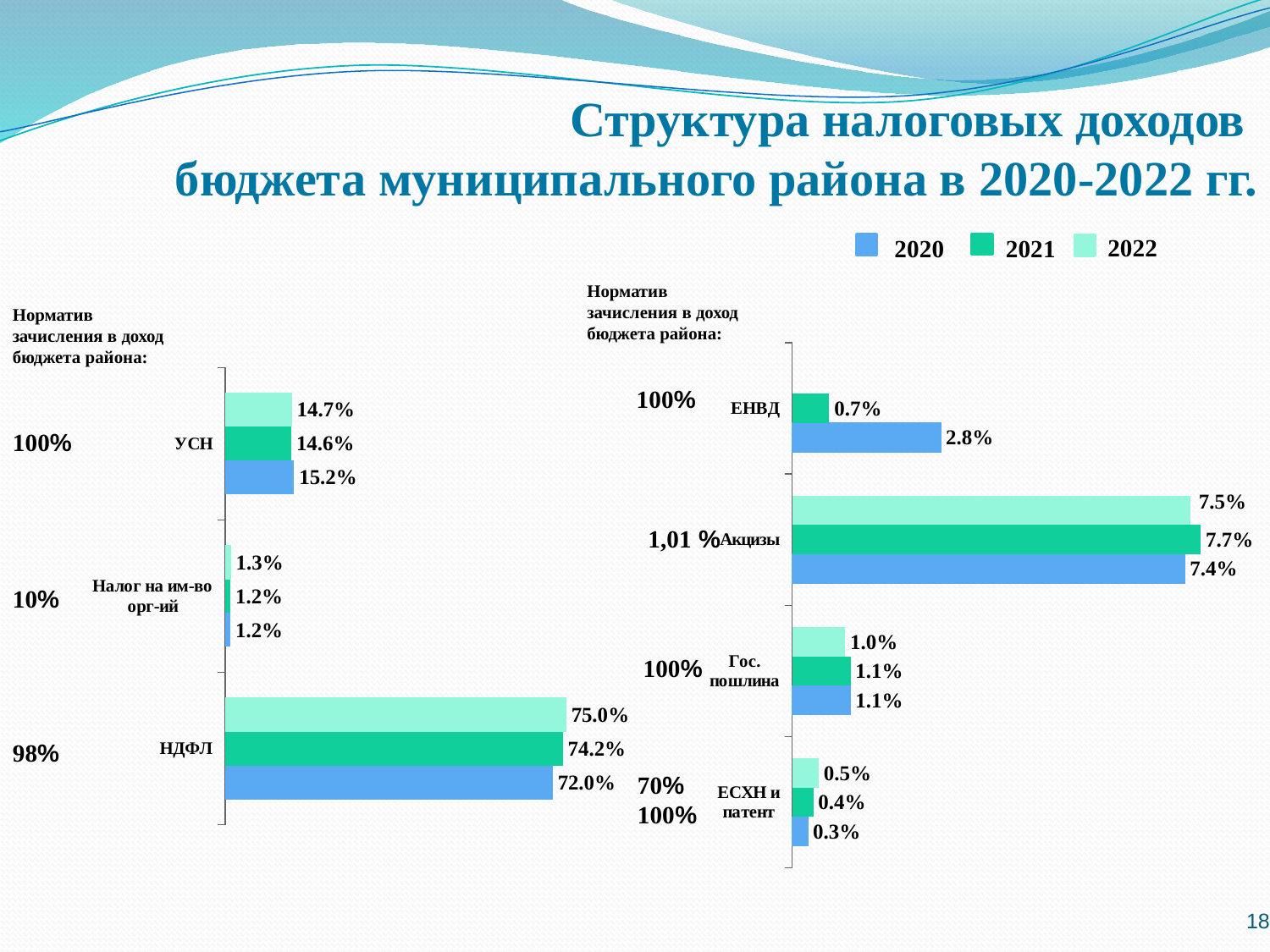
What kind of chart is used on the slide? Bar chart On the left chart, which category has the highest 2022 value? НДФЛ On the left chart, what is the 2022 value for УСН? 14.7% How many categories are shown on the right chart? 4 On the right chart, what is the 2021 value for Акцизы? 7.7% On the right chart, which category has the lowest 2020 value? ЕСХН и патент On the left chart, what is the difference between the 2022 and 2020 values for НДФЛ? 3.0% On the right chart, what is the 2020 value for ЕНВД? 2.8% On the right chart, what is the difference between the 2020 and 2021 values for ЕНВД? 2.1% How many series does the legend list? 3 On the left chart, what is the 2020 value for НДФЛ? 72.0% On the left chart, which is larger for УСН: the 2020 value or the 2021 value? 2020